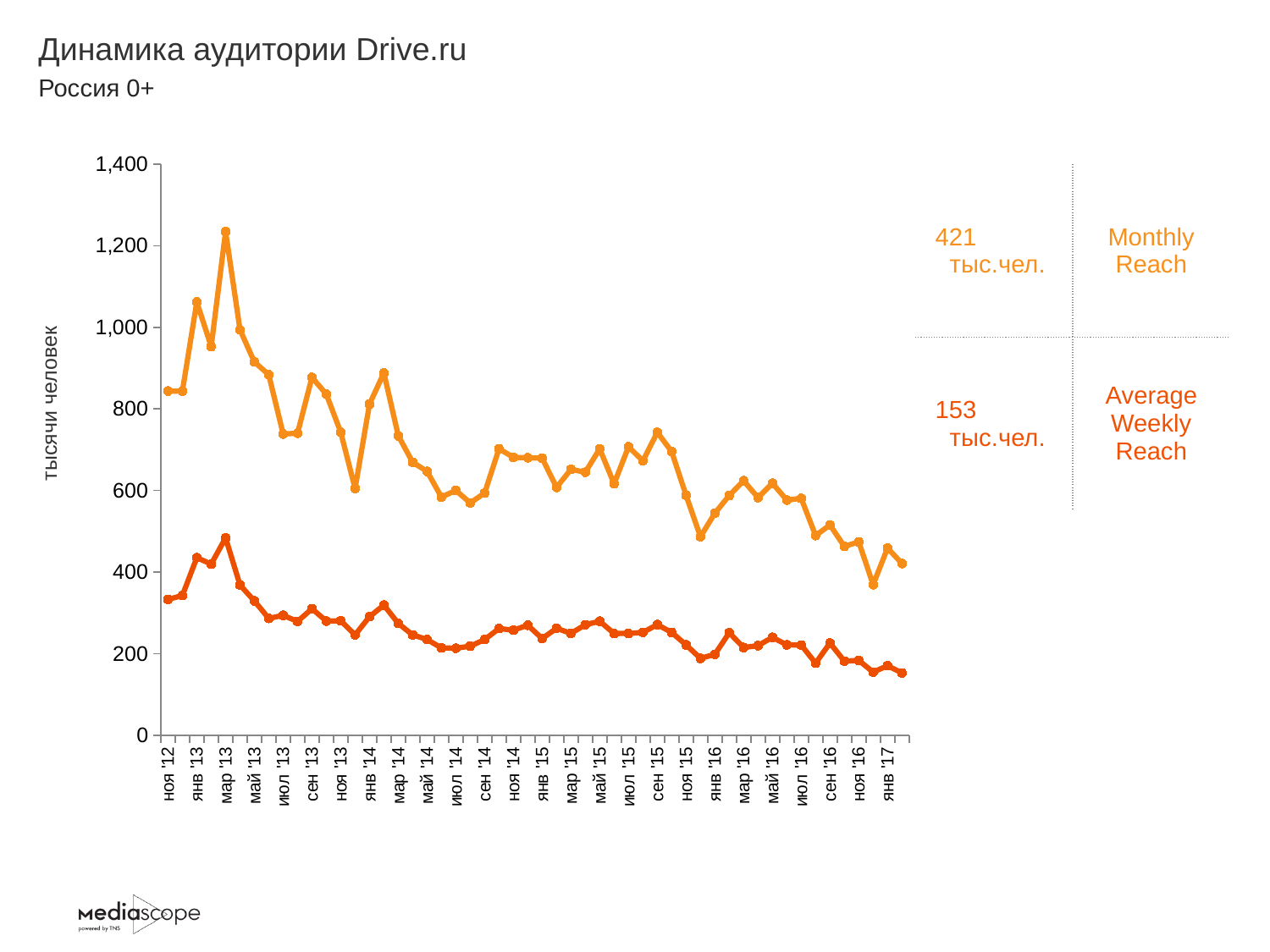
What is the label on the vertical axis of the chart? тысячи человек What is the title of the chart on the slide? Динамика аудитории Drive.ru Is the Average Weekly Reach value for ноя '12 greater or less than 400? less In which month does the Monthly Reach line reach its highest point? мар '13 In which month does the Monthly Reach line reach its lowest point? дек '16 How many series are plotted on the chart? 2 Which series is higher throughout the chart, Monthly Reach or Average Weekly Reach? Monthly Reach What kind of chart is shown on the slide? line chart Is the Monthly Reach value for мар '13 greater or less than 1,000? greater What Average Weekly Reach value is printed on the slide? 153 тыс.чел. What Monthly Reach value is printed on the slide? 421 тыс.чел. In which month does the Average Weekly Reach line reach its highest point? мар '13